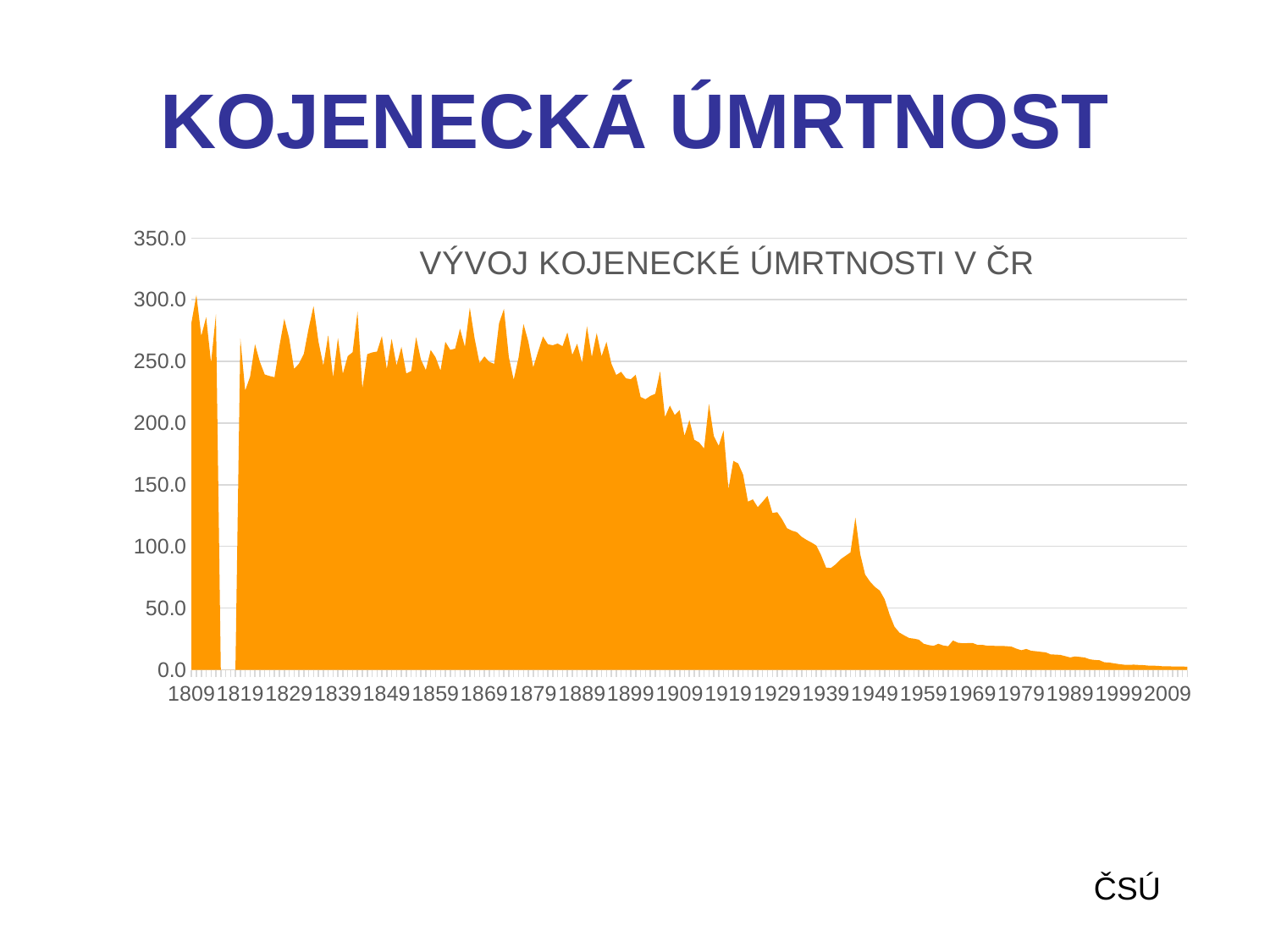
Is the value for 1949 greater or less than 100? less Is the value for 1809 greater or less than 250? greater What is the title of the chart? VÝVOJ KOJENECKÉ ÚMRTNOSTI V ČR Is the value for 2009 greater or less than 50? less What kind of chart is shown on the slide? Area chart What is the highest value shown on the y axis? 350.0 Which year has the larger value, 1899 or 1959? 1899 Which year has the larger value, 1809 or 2009? 1809 Overall, do the values rise or fall from 1809 to 2009 along the x axis? Fall